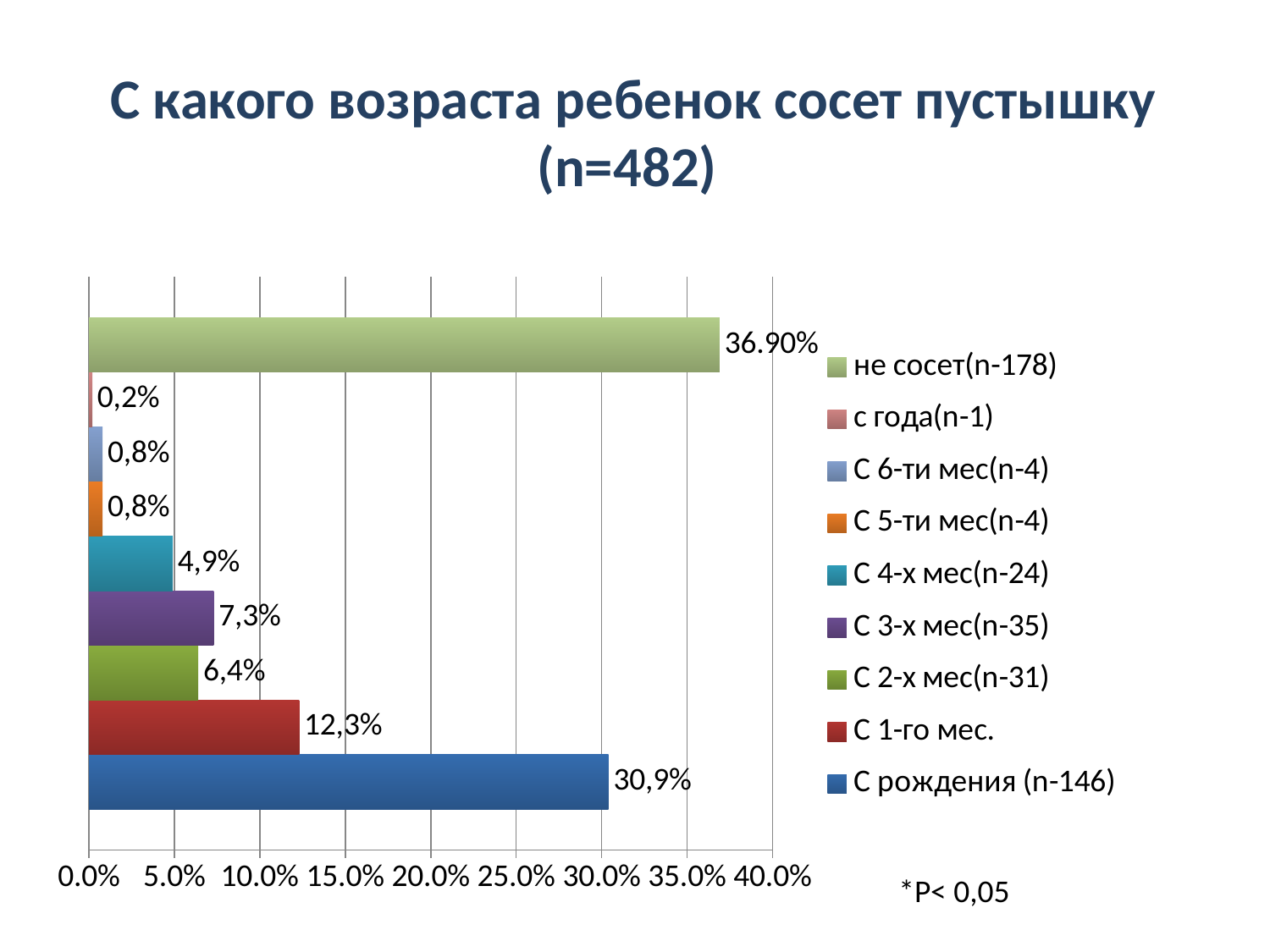
What is the value for "С 3-х мес(n-35)"? 7,3% What type of chart is shown on the slide? bar chart What is the title of the chart? С какого возраста ребенок сосет пустышку (n=482) Which category has the highest value? не сосет(n-178) How many entries does the legend list? 9 What is the value for "не сосет(n-178)"? 36.90% What is the value for "С рождения (n-146)"? 30,9% What is the value for "С 1-го мес."? 12,3% What is the difference between the values for "С 3-х мес(n-35)" and "С 4-х мес(n-24)"? 2,4 percentage points Which category has the lowest value? с года(n-1) Which is larger, the value for "С 3-х мес(n-35)" or for "С 2-х мес(n-31)"? С 3-х мес(n-35) What is the value for "с года(n-1)"? 0,2%